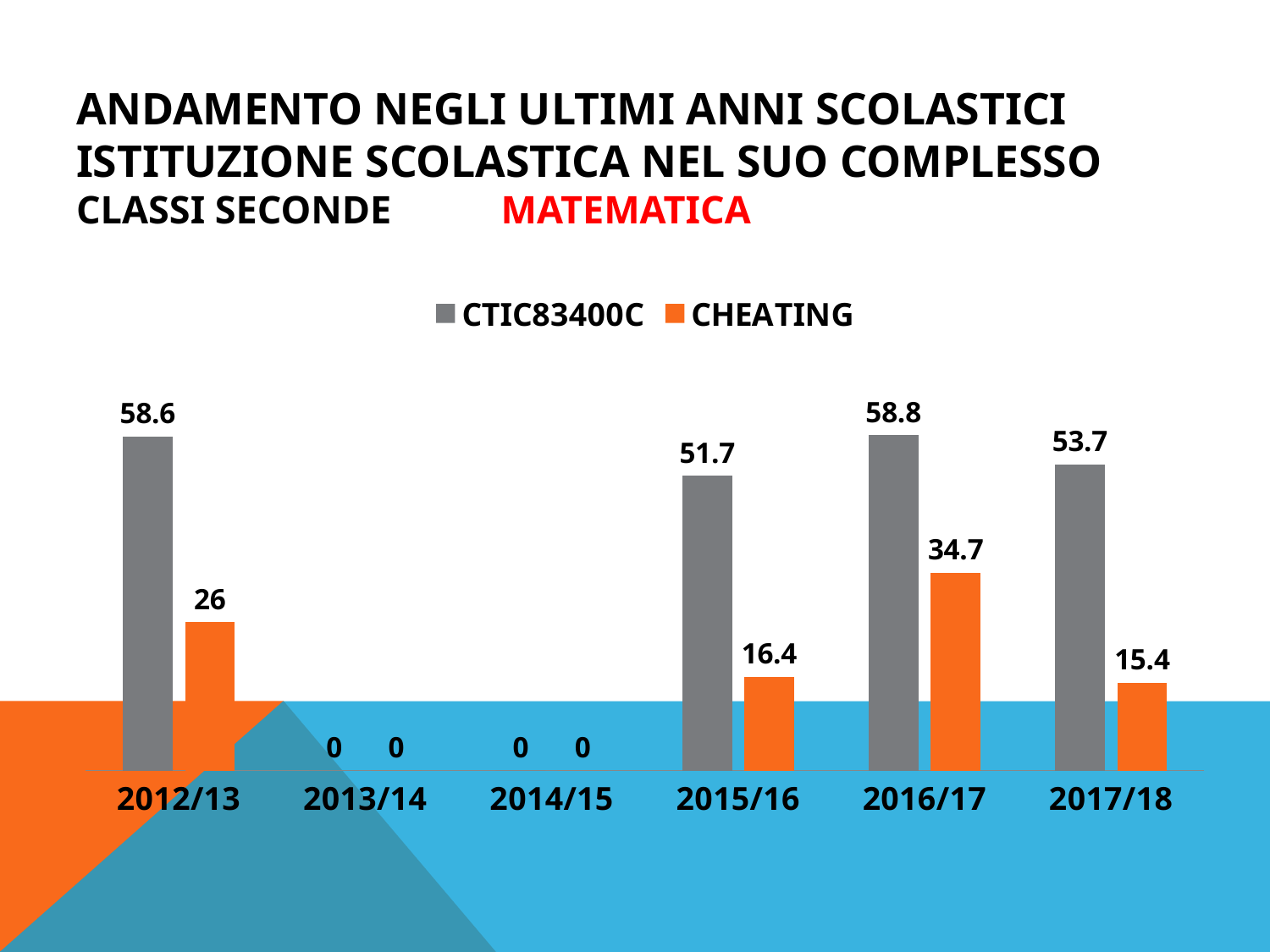
Which colour represents the CHEATING series in the legend? orange What is the CTIC83400C value for 2012/13? 58.6 How many school years are shown on the x axis? 6 What is the CHEATING value for 2017/18? 15.4 What is the CHEATING value for 2016/17? 34.7 What is the difference between the CTIC83400C values for 2016/17 and 2017/18? 5.1 Which is larger, the CHEATING value for 2012/13 or for 2015/16? 2012/13 Which school year has the highest CTIC83400C value? 2016/17 What kind of chart is shown on the slide? bar chart What is the difference between the CTIC83400C and CHEATING values in 2015/16? 35.3 Which school year has the highest CHEATING value? 2016/17 How many series does the legend list? 2